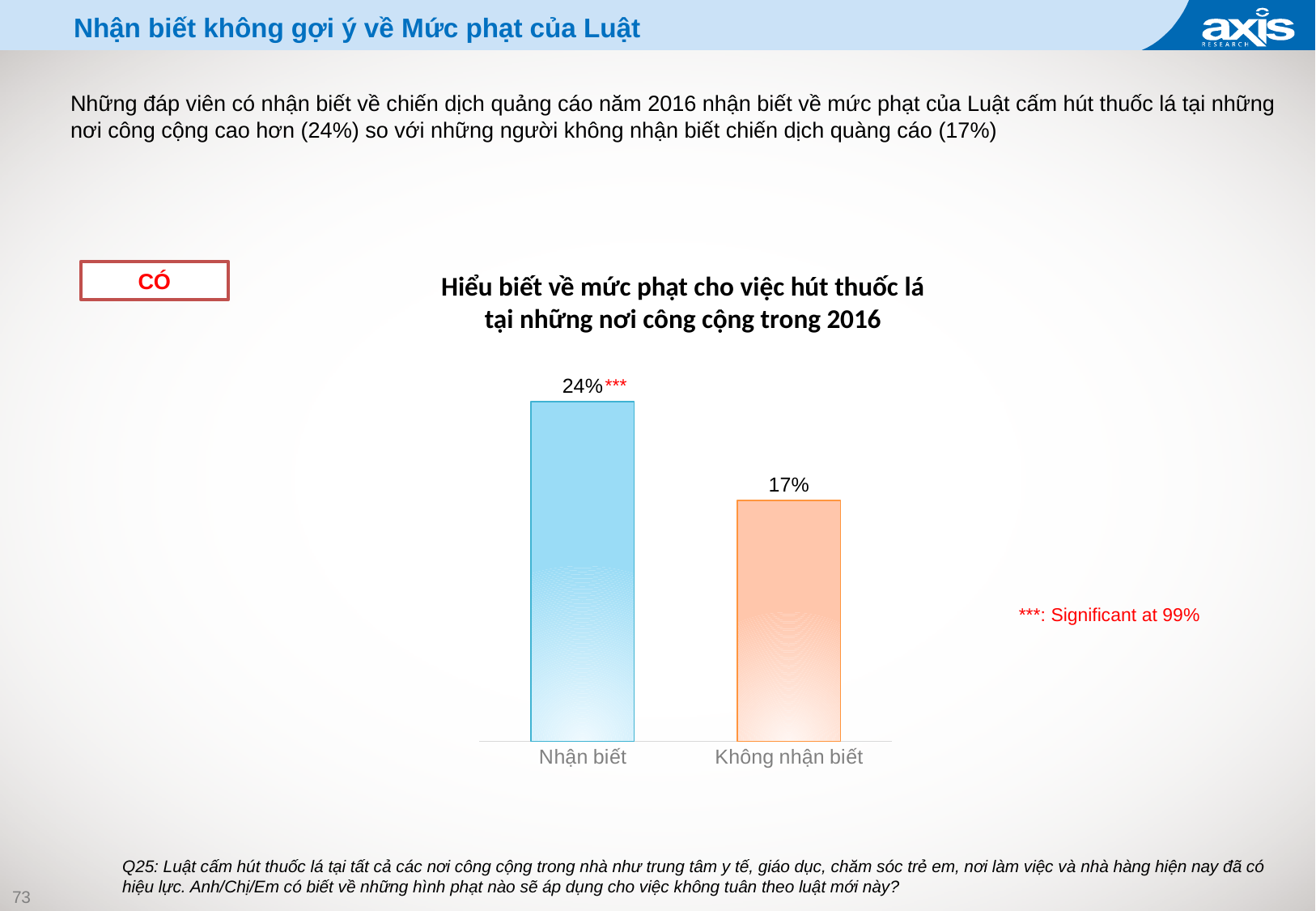
What is the difference between the values for Nhận biết and Không nhận biết? 7% Which category has the lowest value? Không nhận biết How many categories are shown in the chart? 2 What kind of chart is shown on the slide? Bar chart Which category's bar is marked with *** (significant at 99%)? Nhận biết Which category has the highest value? Nhận biết What is the value for Nhận biết? 24% What is the title of the chart? Hiểu biết về mức phạt cho việc hút thuốc lá tại những nơi công cộng trong 2016 What is the value for Không nhận biết? 17% Which is larger, the value for Nhận biết or the value for Không nhận biết? Nhận biết